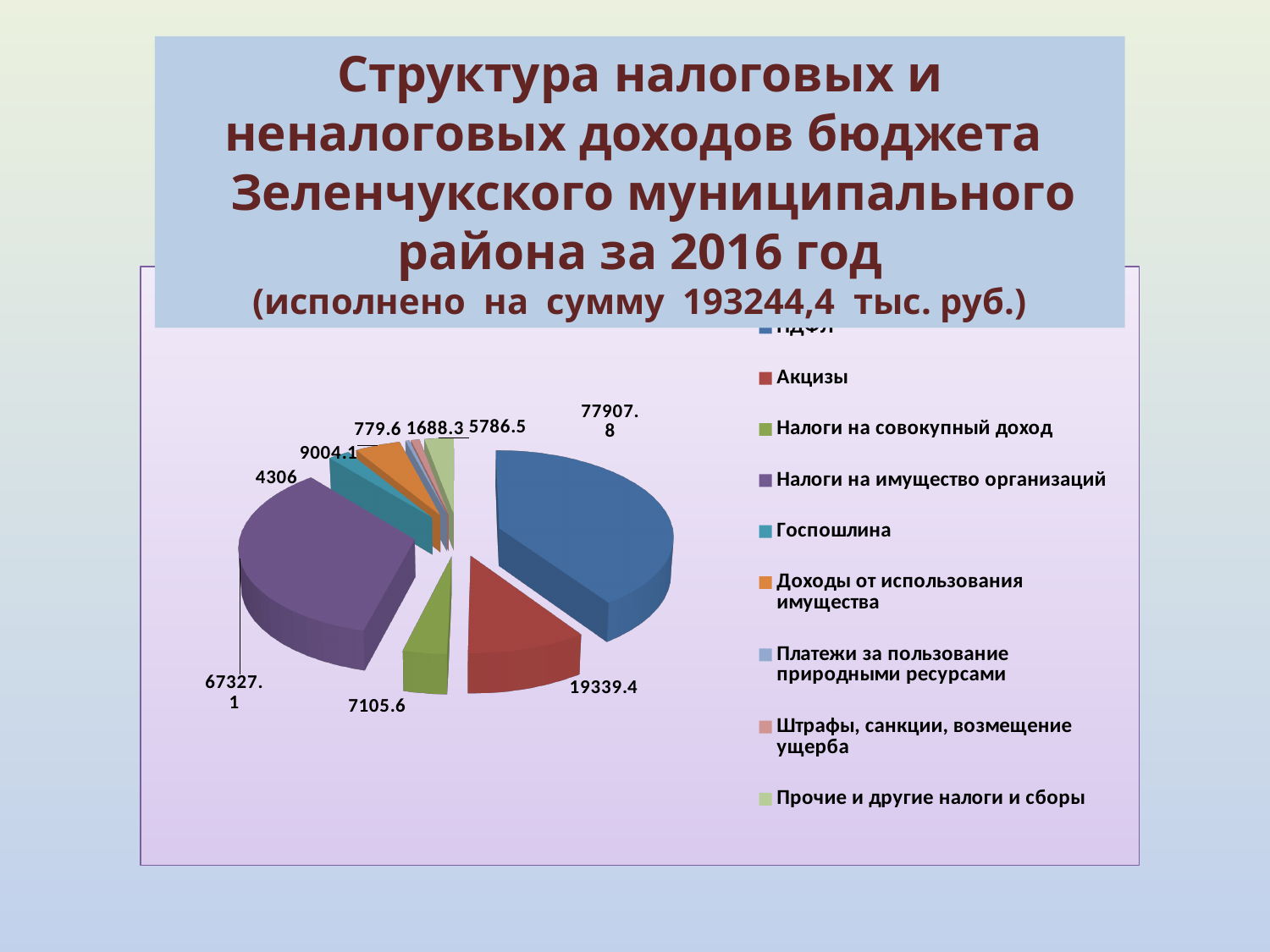
What total sum (in тыс. руб.) is stated in the chart title as executed? 193244,4 тыс. руб. What is the difference between the Акцизы value and the Налоги на совокупный доход value? 12233.8 What is the value shown for the Акцизы slice? 19339.4 How many slices does the pie chart have? 9 What is the value of the smallest slice in the pie chart? 779.6 Which is larger, the Акцизы slice or the Налоги на совокупный доход slice? Акцизы What is the value shown for the Налоги на совокупный доход slice? 7105.6 What kind of chart is shown on the slide? Pie chart What is the value shown for the Налоги на имущество организаций slice? 67327.1 What colour is the Налоги на имущество организаций slice? Purple What is the difference between the largest slice (77907.8) and the Налоги на имущество организаций slice? 10580.7 What is the value of the largest slice in the pie chart? 77907.8